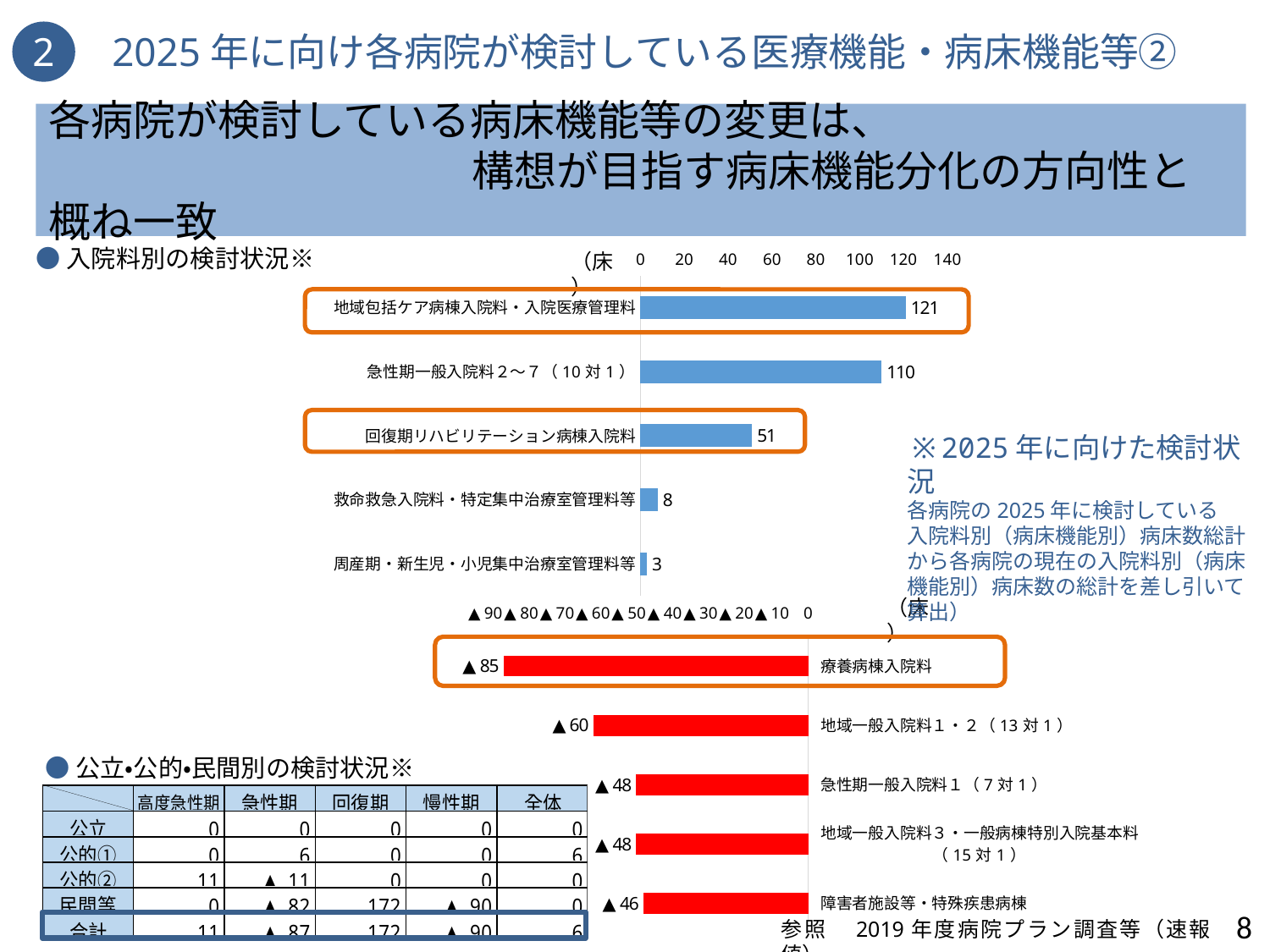
In the upper blue bar chart, which category has the highest value? 地域包括ケア病棟入院料・入院医療管理料 In the lower red bar chart, what is the value for 療養病棟入院料? ▲85 In the lower red bar chart, how many categories are plotted? 5 In the upper blue bar chart, what is the difference between the values for 地域包括ケア病棟入院料・入院医療管理料 and 急性期一般入院料２～７（10対1）? 11 In the upper blue bar chart, what is the value for 地域包括ケア病棟入院料・入院医療管理料? 121 In the upper blue bar chart, is the value for 急性期一般入院料２～７（10対1） greater or less than 100? greater In the lower red bar chart, what is the value for 障害者施設等・特殊疾患病棟? ▲46 What type of chart is the upper blue chart? Bar chart In the lower red bar chart, which category has the largest decrease? 療養病棟入院料 In the upper blue bar chart, which category has the lowest value? 周産期・新生児・小児集中治療室管理料等 In the upper blue bar chart, what is the value for 回復期リハビリテーション病棟入院料? 51 In the upper blue bar chart, how many categories are plotted? 5